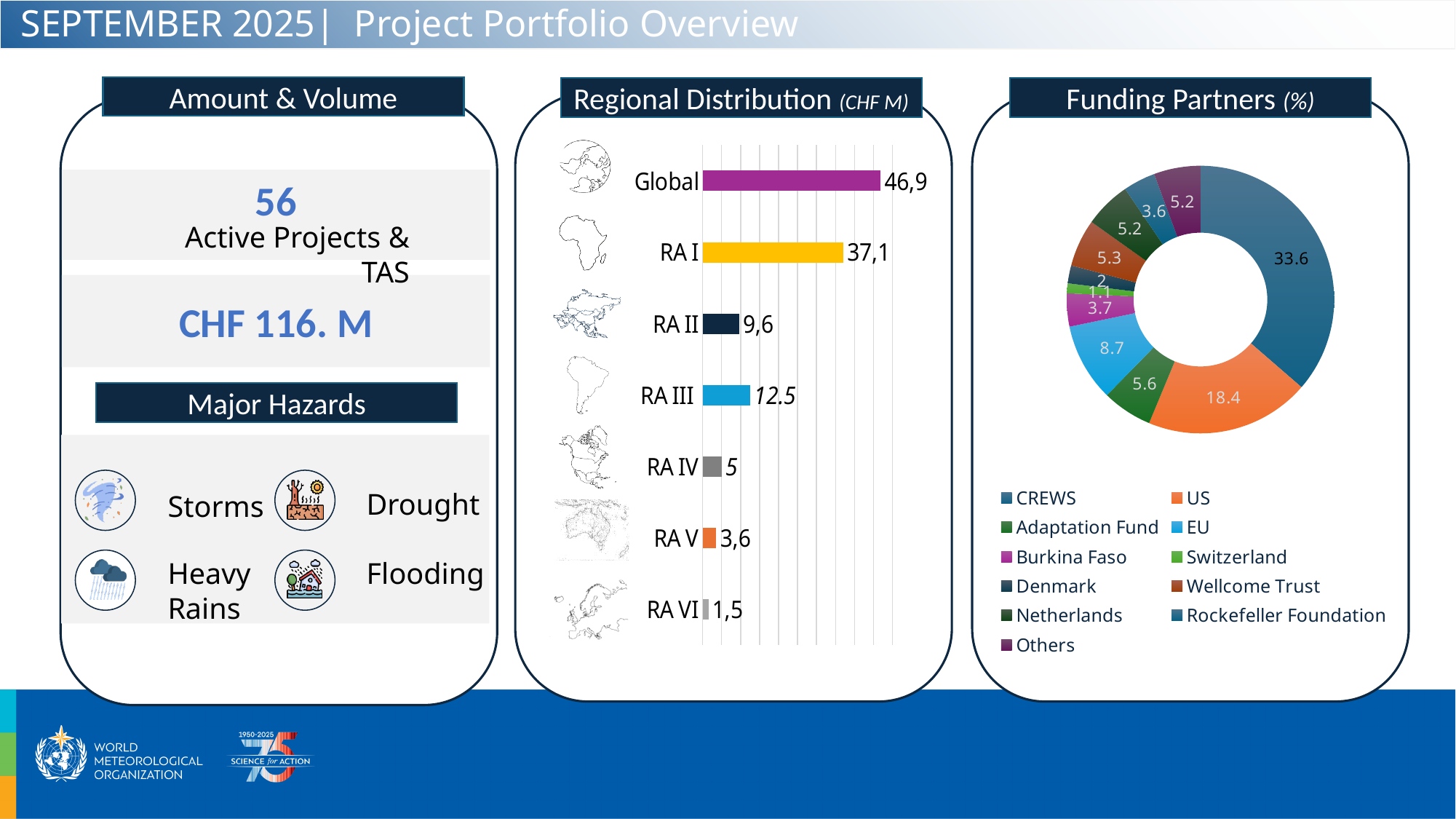
In the Regional Distribution chart, which region has the lowest value? RA VI In the Regional Distribution chart, which category has the highest value? Global In the Funding Partners chart, which is larger, EU or Adaptation Fund? EU What kind of chart is the Regional Distribution chart? Bar chart In the Regional Distribution chart, what is the value for RA I? 37,1 In the Regional Distribution chart, what is the value for Global? 46,9 In the Funding Partners chart, what percentage is shown for CREWS? 33.6 In the Regional Distribution chart, how many categories are shown? 7 In the Regional Distribution chart, what is the difference between the Global value and the RA I value? 9,8 How many entries does the legend of the Funding Partners chart list? 11 In the Regional Distribution chart, what is the value for RA V? 3,6 In the Funding Partners chart, what percentage is shown for US? 18.4